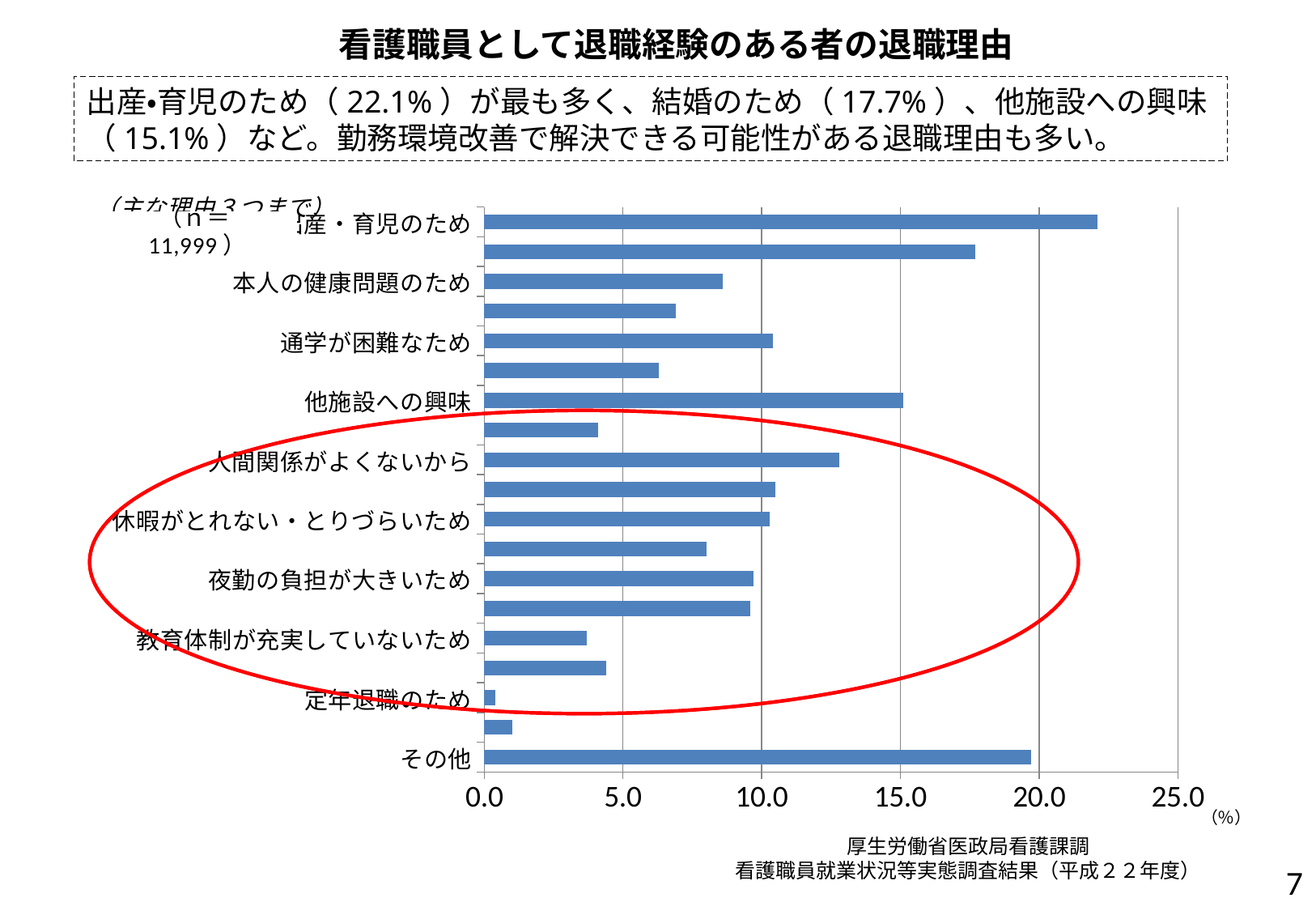
What is the value for 出産・育児のため? 22.1% Is the value for 教育体制が充実していないため greater or less than 5.0? less Is the value for 人間関係がよくないから greater or less than 10.0? greater Is the value for 本人の健康問題のため greater or less than 10.0? less Which is larger, the value for 人間関係がよくないから or the value for 本人の健康問題のため? 人間関係がよくないから What kind of chart is shown on the slide? bar chart Which category has the longest bar in the chart? 出産・育児のため What is the maximum value shown on the horizontal axis of the chart? 25.0 What is the difference between the values for 出産・育児のため and 他施設への興味? 7.0% What is the value for 他施設への興味? 15.1% Which labeled category has the shortest bar in the chart? 定年退職のため